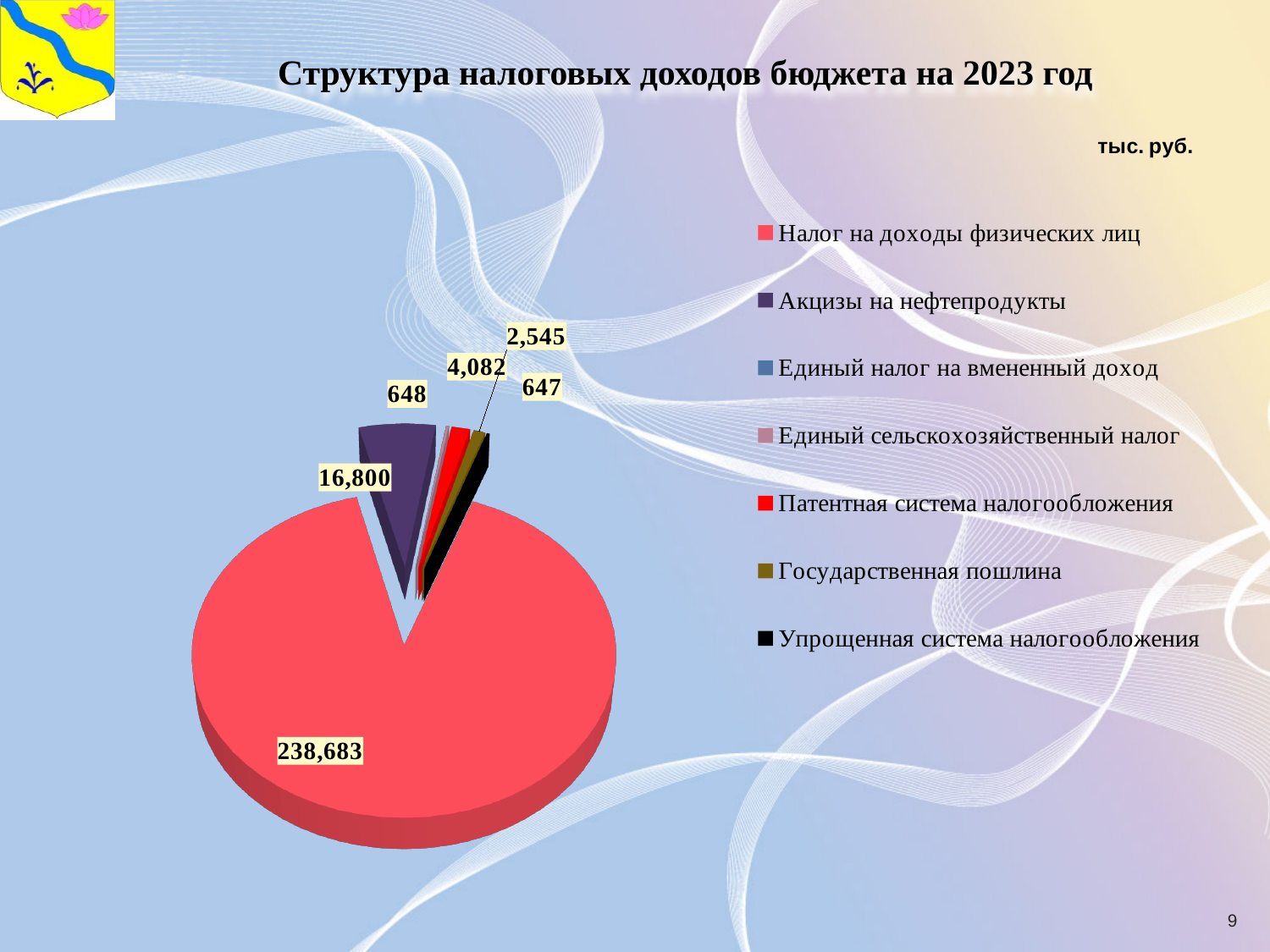
What is the value for Налог на доходы физических лиц? 238,683 What is the difference between the values for Налог на доходы физических лиц and Акцизы на нефтепродукты? 221,883 What is the title of the chart? Структура налоговых доходов бюджета на 2023 год What colour is the slice for Налог на доходы физических лиц? red In what units are the values on the chart given? тыс. руб. Which is larger, Налог на доходы физических лиц or Акцизы на нефтепродукты? Налог на доходы физических лиц How many categories does the legend list? 7 Which category has the largest slice of the pie? Налог на доходы физических лиц What kind of chart is shown on the slide? pie chart What is the value for Акцизы на нефтепродукты? 16,800